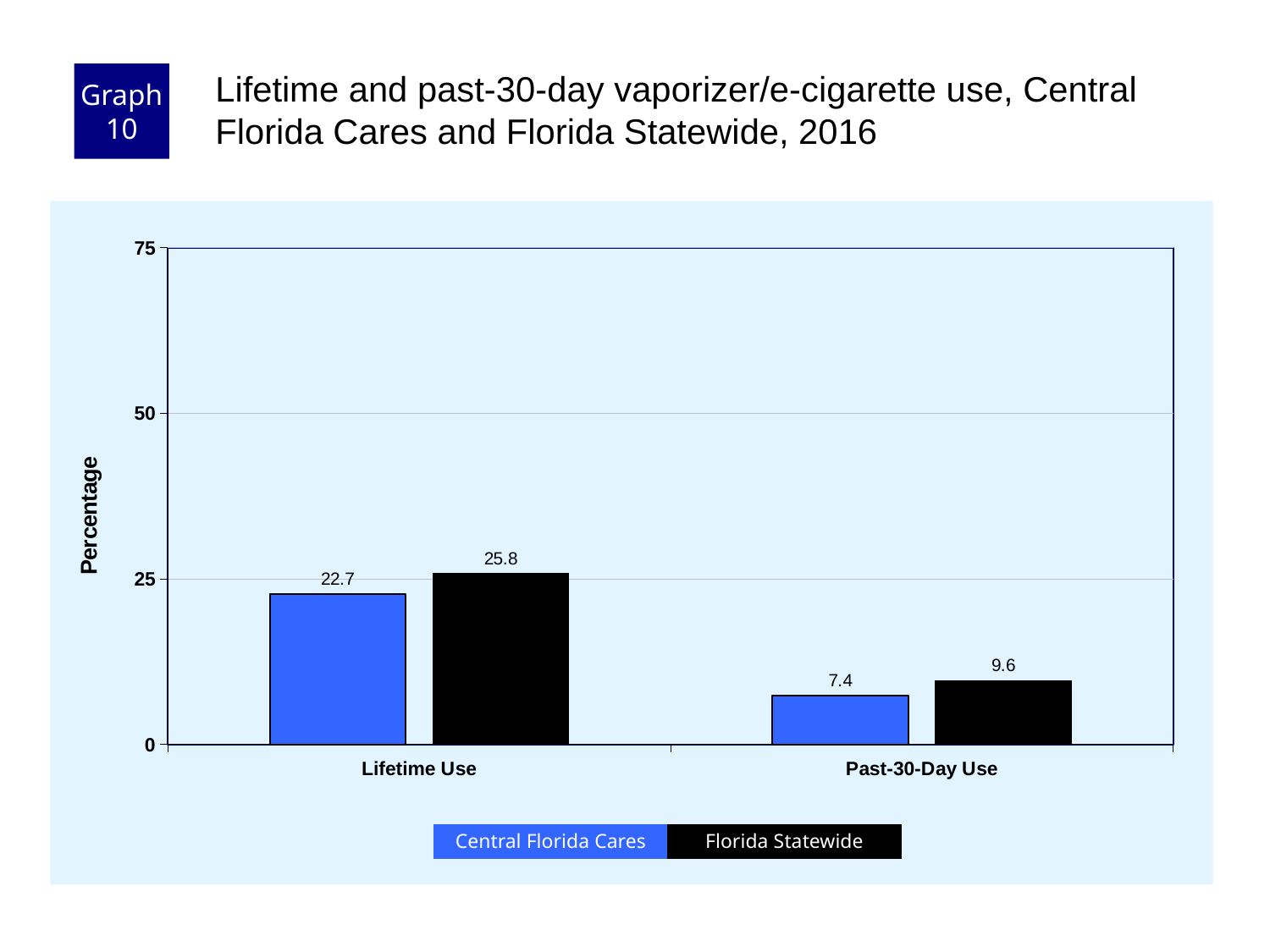
What is the difference between Florida Statewide and Central Florida Cares for Lifetime Use? 3.1 How many series does the legend list? 2 What is the Past-30-Day Use value for Central Florida Cares? 7.4 Which bar has the highest value on the chart? Florida Statewide, Lifetime Use What is the Lifetime Use value for Central Florida Cares? 22.7 What is the Lifetime Use value for Florida Statewide? 25.8 What is the label on the vertical axis? Percentage What kind of chart is shown on the slide? Bar chart What is the difference between Florida Statewide and Central Florida Cares for Past-30-Day Use? 2.2 Which bar has the lowest value on the chart? Central Florida Cares, Past-30-Day Use What is the Past-30-Day Use value for Florida Statewide? 9.6 For Past-30-Day Use, which is larger: Central Florida Cares or Florida Statewide? Florida Statewide